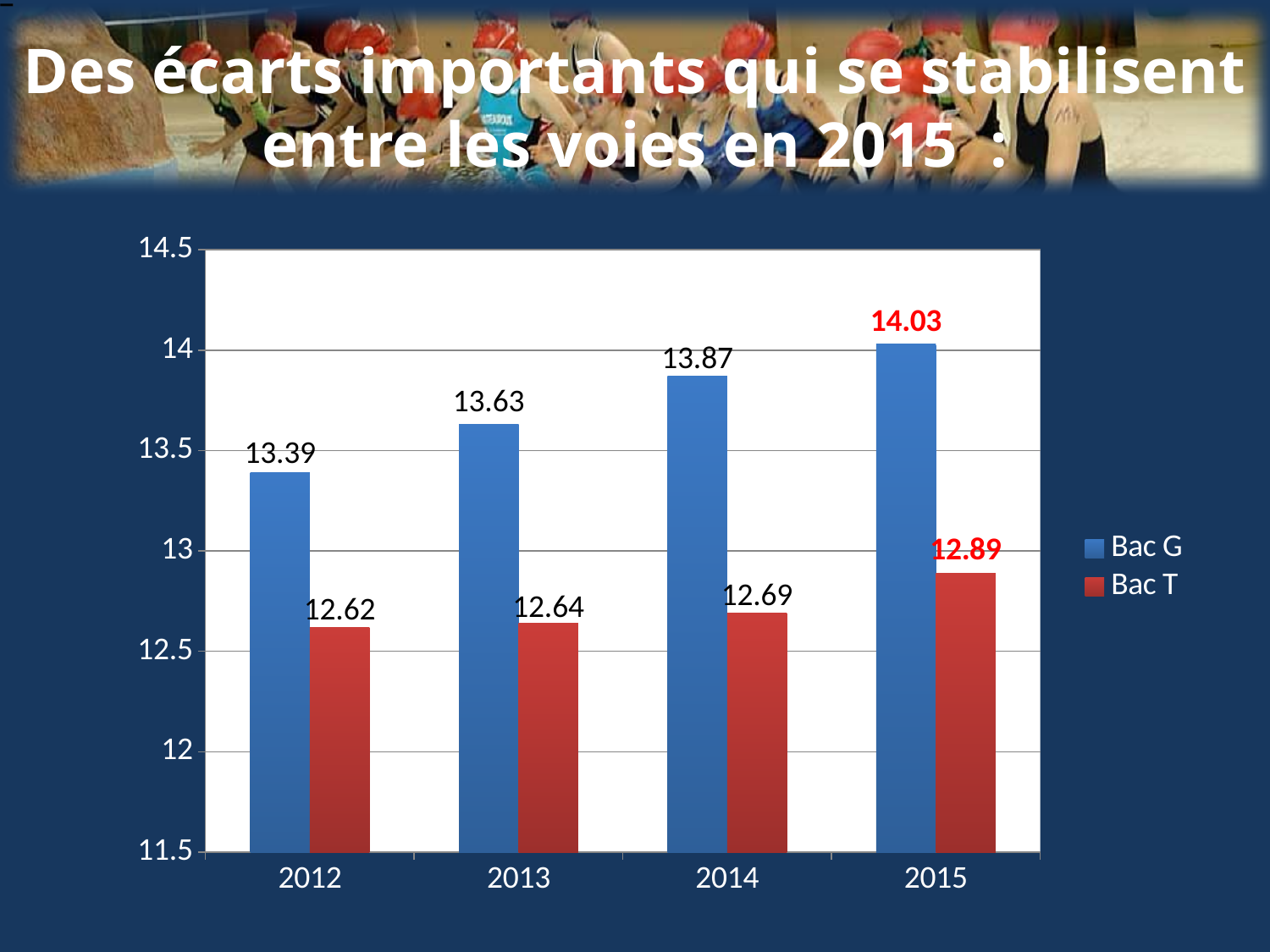
What kind of chart is shown on the slide? Bar chart In which year is the Bac T value highest? 2015 What is the value for Bac T in 2012? 12.62 What is the difference between Bac G in 2014 and Bac G in 2013? 0.24 Which is larger in 2014, Bac G or Bac T? Bac G What is the value for Bac G in 2015? 14.03 In which year is the Bac G value lowest? 2012 What is the difference between Bac G and Bac T in 2015? 1.14 How many years are shown on the x axis? 4 What is the value for Bac G in 2013? 13.63 How many series does the legend list? 2 Do the Bac G values rise or fall from 2012 to 2015? Rise